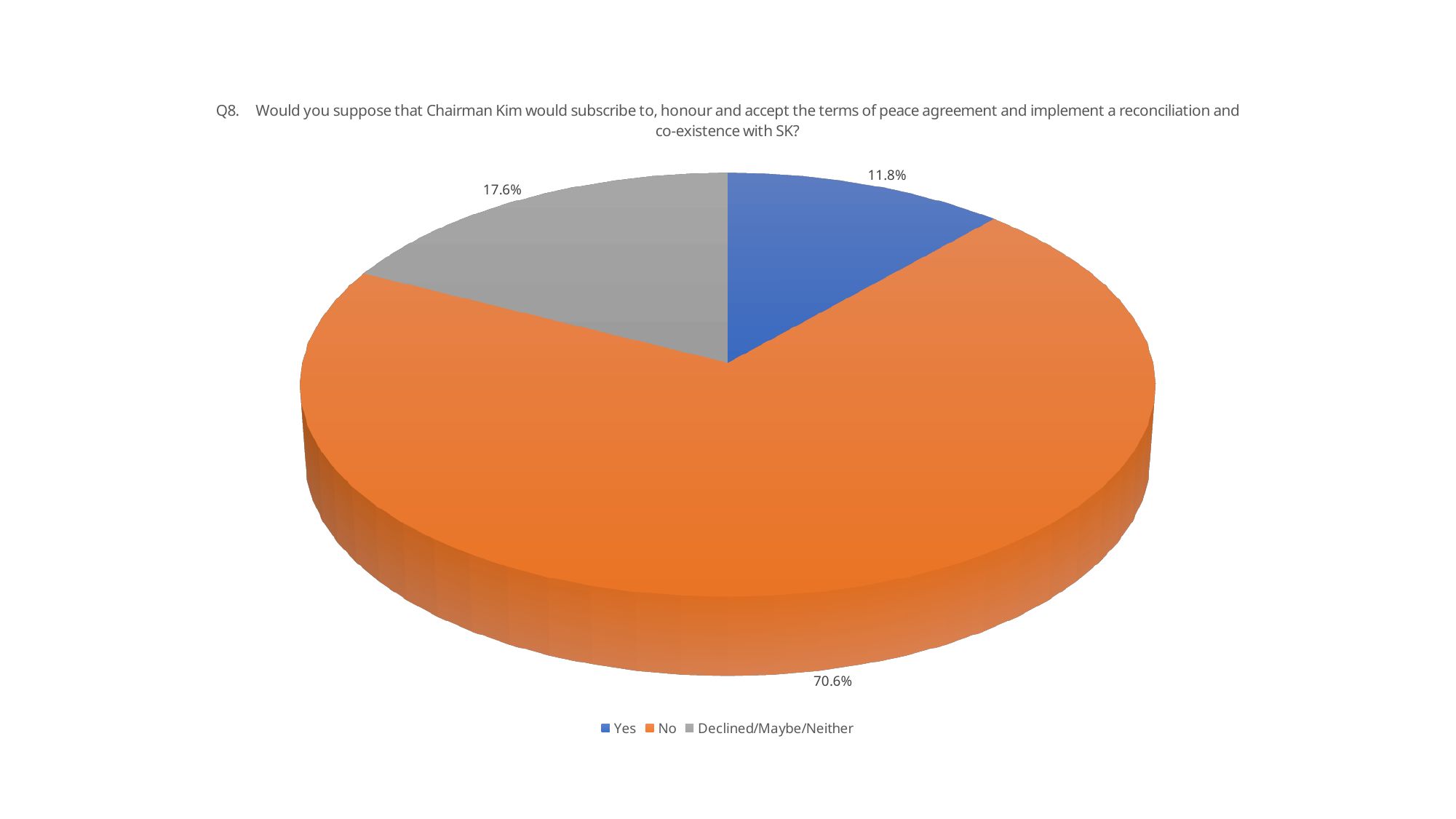
What kind of chart is shown on the slide? Pie chart What percentage of respondents fall under "Declined/Maybe/Neither"? 17.6% What colour is the "No" slice in the pie chart? Orange What colour is the "Yes" slice in the pie chart? Blue Which response category has the largest share of the pie? No What is the difference in percentage points between the "No" and "Yes" shares? 58.8 What percentage of respondents answered "Yes"? 11.8% Which is larger, the share for "Yes" or the share for "Declined/Maybe/Neither"? Declined/Maybe/Neither Which response category has the smallest share of the pie? Yes What is the difference in percentage points between the "Declined/Maybe/Neither" and "Yes" shares? 5.8 What percentage of respondents answered "No"? 70.6% How many categories does the pie chart show? 3